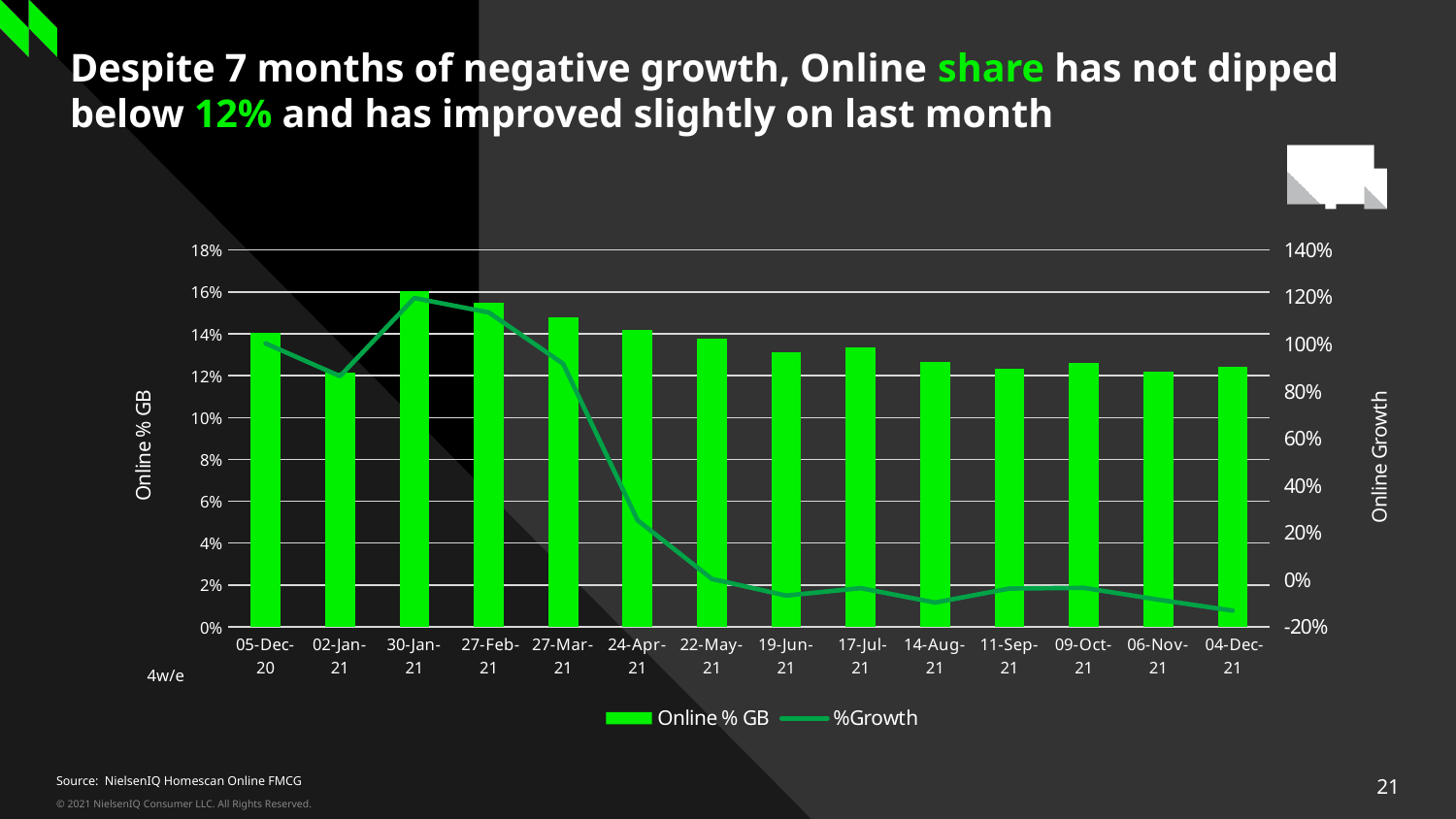
Is the %Growth value for 04-Dec-21 greater or less than 0%? less Is the %Growth value for 24-Apr-21 greater or less than 60%? less Which has the larger Online % GB bar, 30-Jan-21 or 04-Dec-21? 30-Jan-21 Which period has the highest Online % GB bar? 30-Jan-21 Is the Online % GB value for 14-Aug-21 greater or less than 14%? less How many series does the legend list? 2 Does the %Growth line generally rise or fall from 30-Jan-21 to 04-Dec-21? fall What type of chart is shown on the slide? Combination bar and line chart What label is shown on the left vertical axis? Online % GB How many 4w/e periods are plotted on the x axis? 14